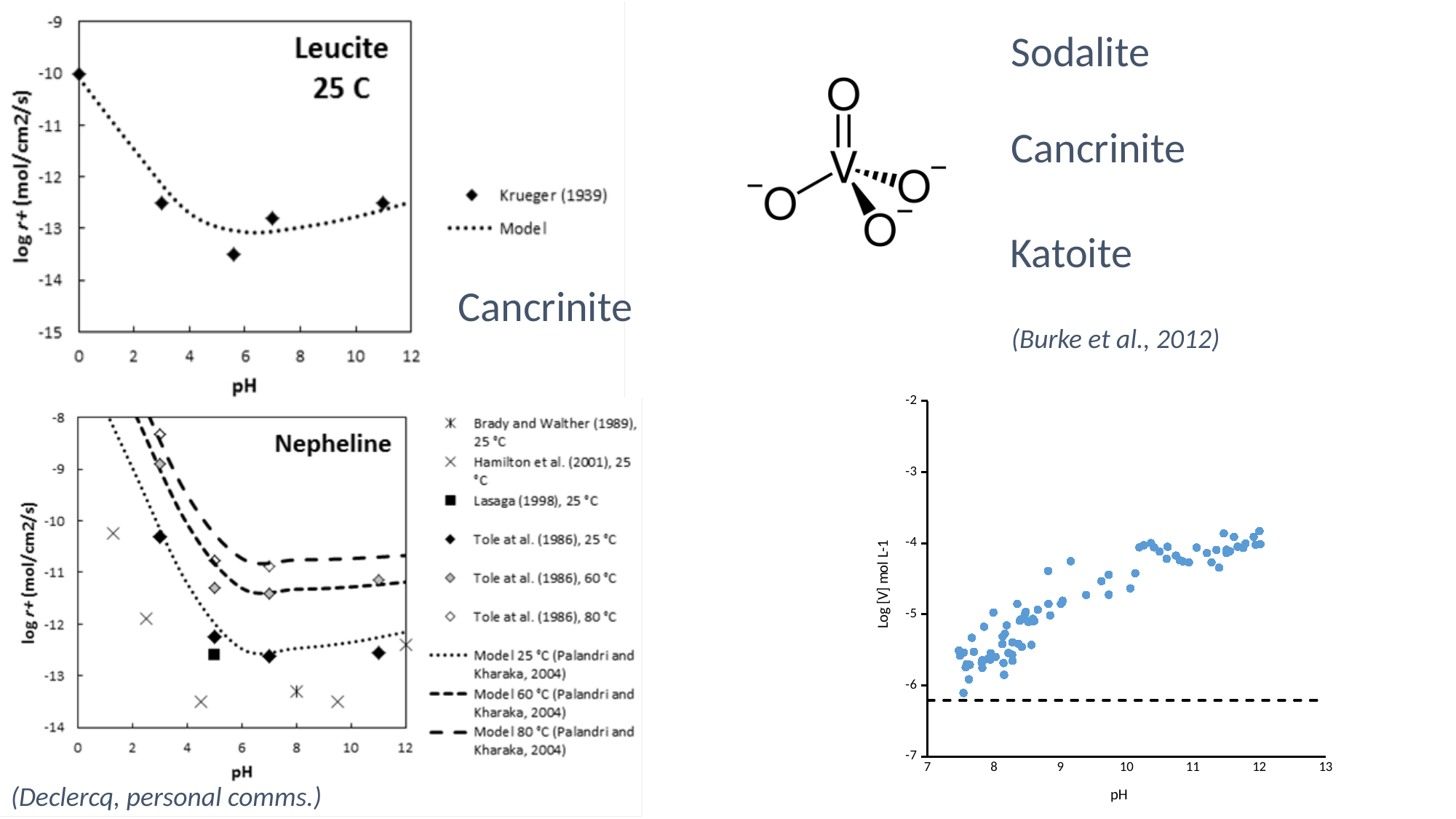
In the Leucite 25 C chart, is the Krueger (1939) value near pH 5.5 greater or less than -13? less In the Nepheline chart, is the Lasaga (1998) value at pH 5 greater or less than -12? less In the Nepheline chart, how many entries does the legend list? 9 In the Leucite 25 C chart, what is the x-axis label? pH In the Leucite 25 C chart, which Krueger (1939) point has the lowest log r+ value: the one at pH 0 or the one near pH 5.5? the one near pH 5.5 What kind of chart is the bottom-right chart of Log [V] versus pH? scatter chart In the Nepheline chart, which model temperature curve lies highest on the plot at pH 12? Model 80 °C In the Leucite 25 C chart, what is the log r+ value of the Krueger (1939) point at pH 0? -10 In the bottom-right scatter chart, are the Log [V] values at pH 12 greater or less than -5? greater In the Leucite 25 C chart, how many series does the legend list? 2 In the bottom-right scatter chart of Log [V] versus pH, do the values rise or fall as pH increases? rise In the Leucite 25 C chart, how many Krueger (1939) data points are plotted? 5